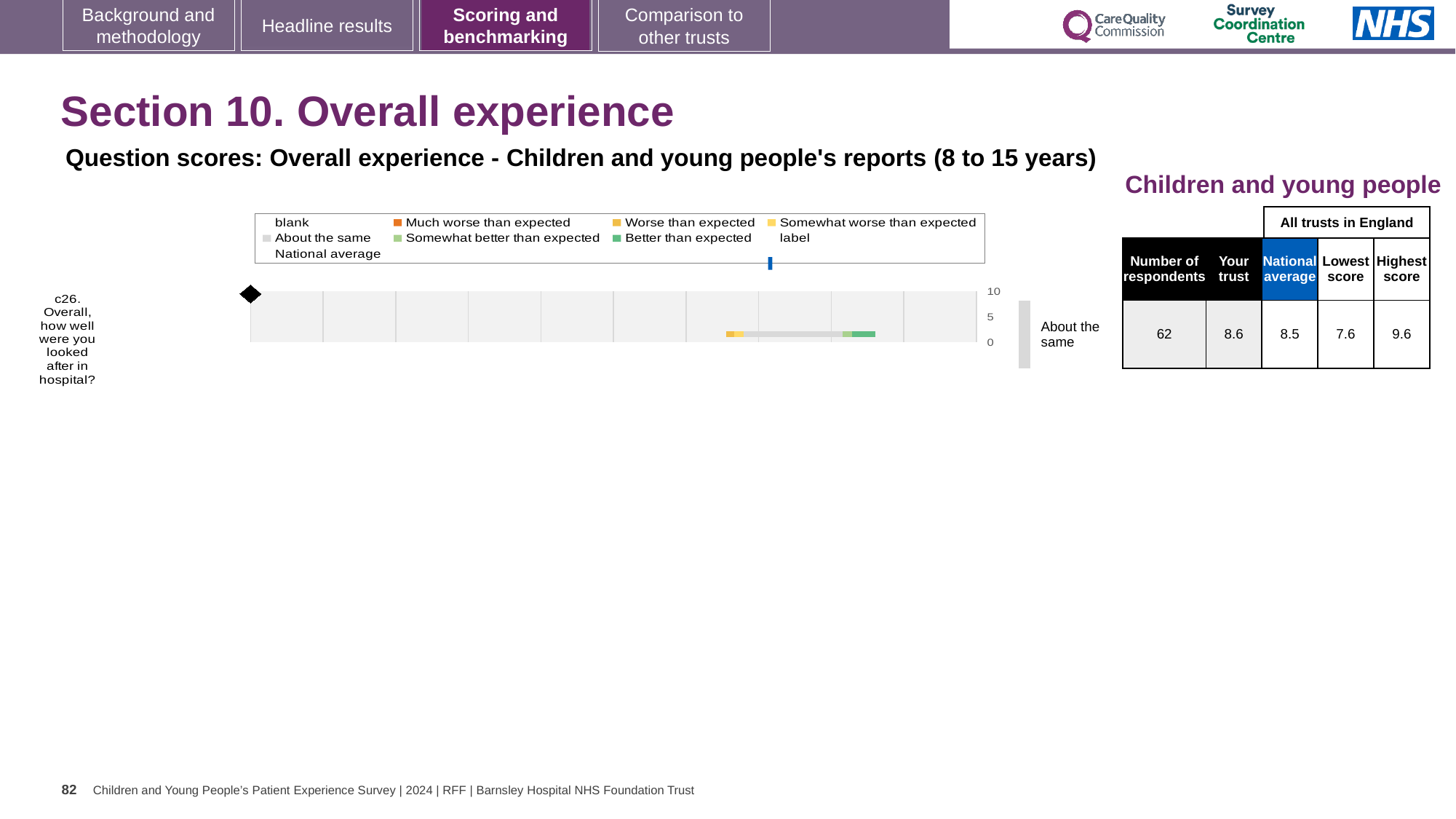
In the table, what is the lowest score among all trusts in England for c26? 7.6 In the table, what is the 'Your trust' score for c26? 8.6 In the table, what is the highest score among all trusts in England for c26? 9.6 What benchmark category label is shown next to the bar for c26? About the same Which question is plotted in the chart? c26. Overall, how well were you looked after in hospital? How many questions (categories) are plotted in the chart? 1 How many respondents answered question c26? 62 What kind of chart is shown on the slide? bar chart Which is larger for c26: the 'Your trust' score or the national average? Your trust What is the highest value shown on the chart's axis? 10 In the table, what is the national average score for c26? 8.5 What is the difference between the highest score and the lowest score for c26? 2.0